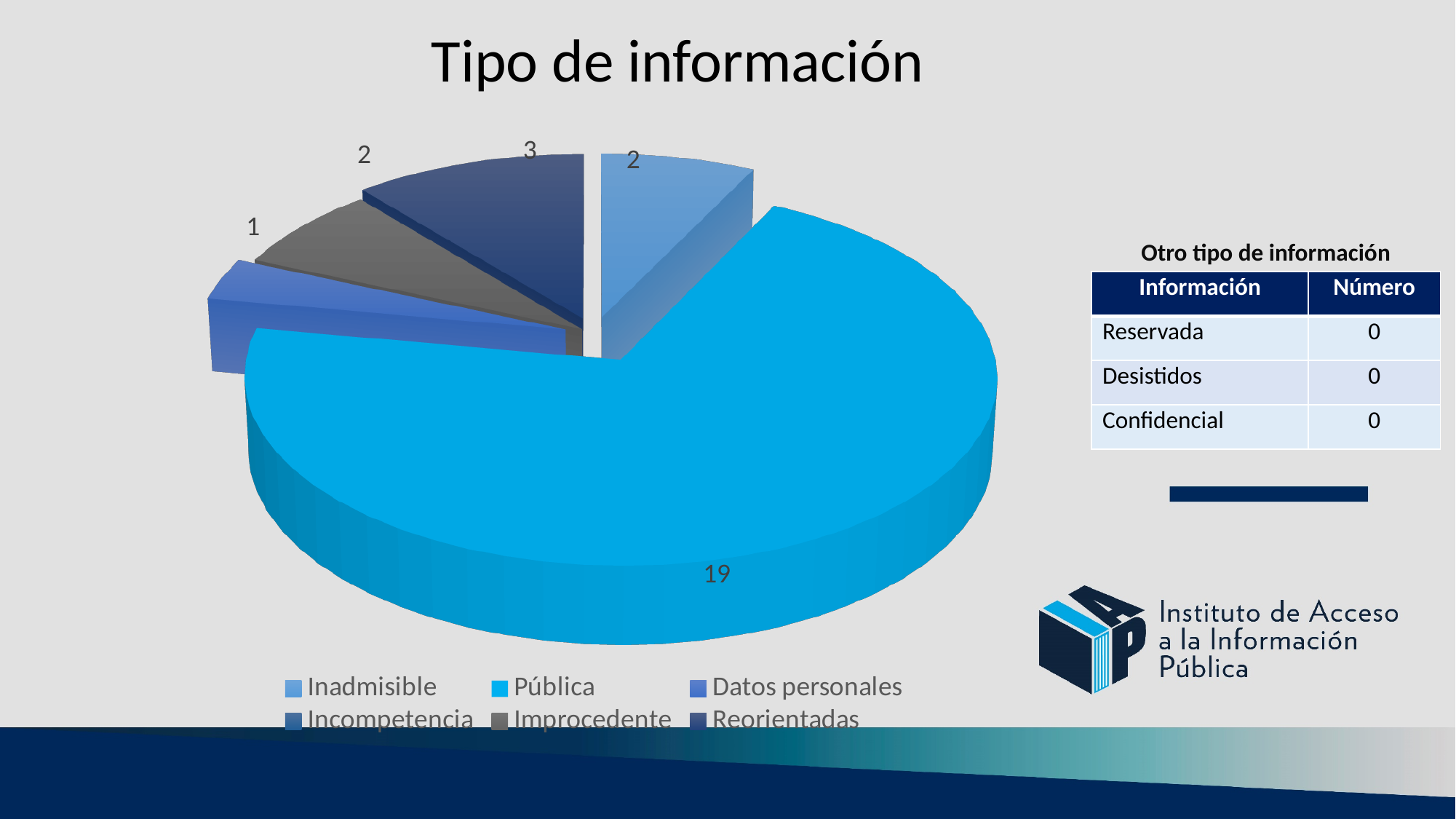
What is the value of the Reorientadas slice in the pie chart? 3 What is the value of the Improcedente slice in the pie chart? 2 What is the title of the chart? Tipo de información What kind of chart is shown on the slide? Pie chart What is the value of the Inadmisible slice in the pie chart? 2 What is the value of the Pública slice in the pie chart? 19 What is the value of the Datos personales slice in the pie chart? 1 What is the difference between the Reorientadas value and the Datos personales value? 2 Which category has the largest slice in the pie chart? Pública How many categories does the chart legend list? 6 What is the difference between the Pública value and the Reorientadas value? 16 Which is larger, the Reorientadas slice or the Inadmisible slice? Reorientadas